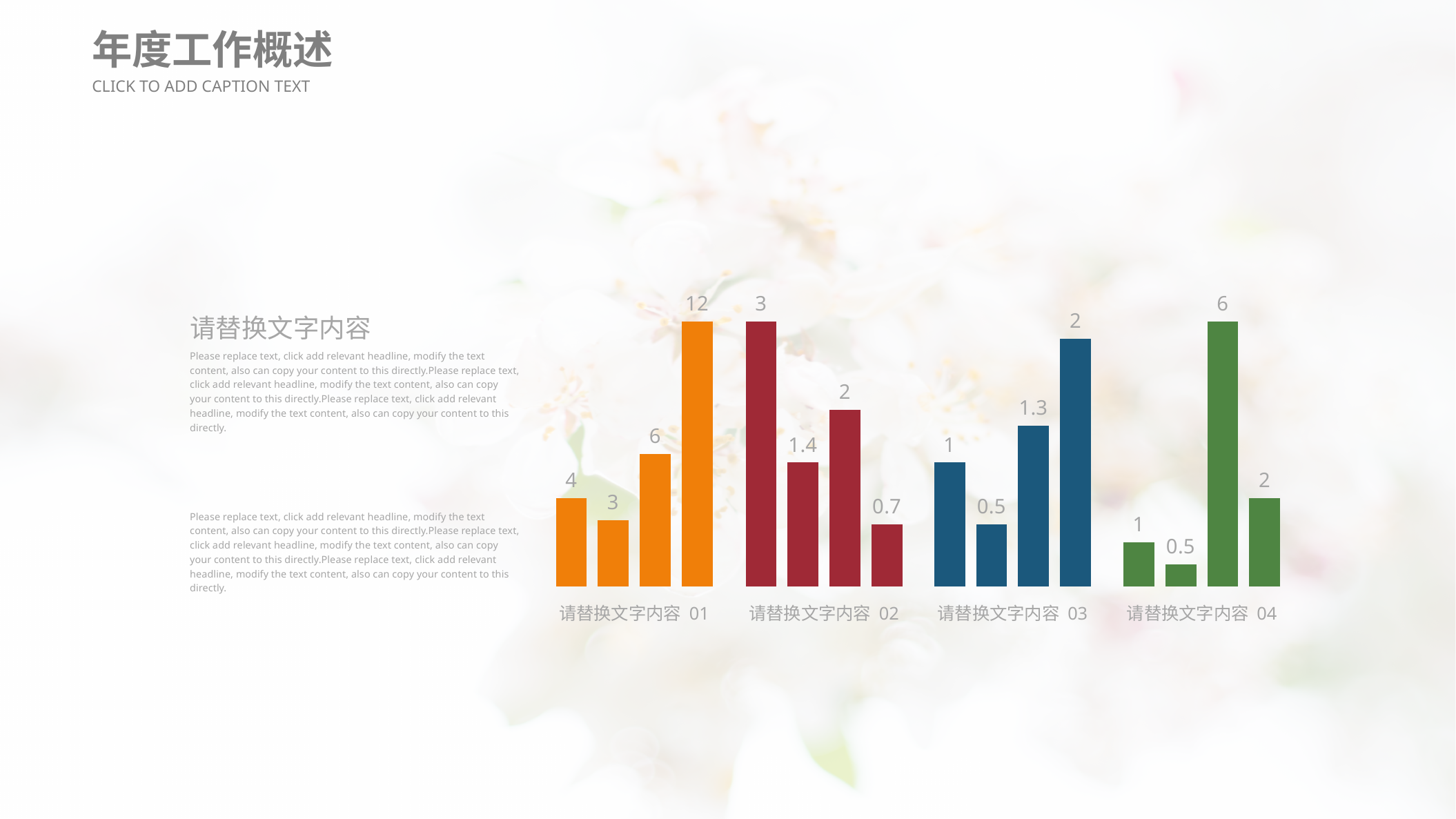
What is the total of the four bars in the group labelled 请替换文字内容 03? 4.8 What kind of chart is shown on the slide? bar chart What is the value of the first bar in the group labelled 请替换文字内容 02? 3 What is the value of the second bar in the group labelled 请替换文字内容 03? 0.5 What is the lowest value shown in the group labelled 请替换文字内容 02? 0.7 Which is larger: the third bar in group 请替换文字内容 02 or the third bar in group 请替换文字内容 03? 请替换文字内容 02 How many category groups are shown along the x axis of the chart? 4 Which group contains the highest bar in the chart? 请替换文字内容 01 What is the value of the third bar in the group labelled 请替换文字内容 04? 6 What is the value of the tallest bar in the group labelled 请替换文字内容 01? 12 What is the difference between the highest and lowest bars in the group labelled 请替换文字内容 01? 9 What colour are the bars in the group labelled 请替换文字内容 04? green